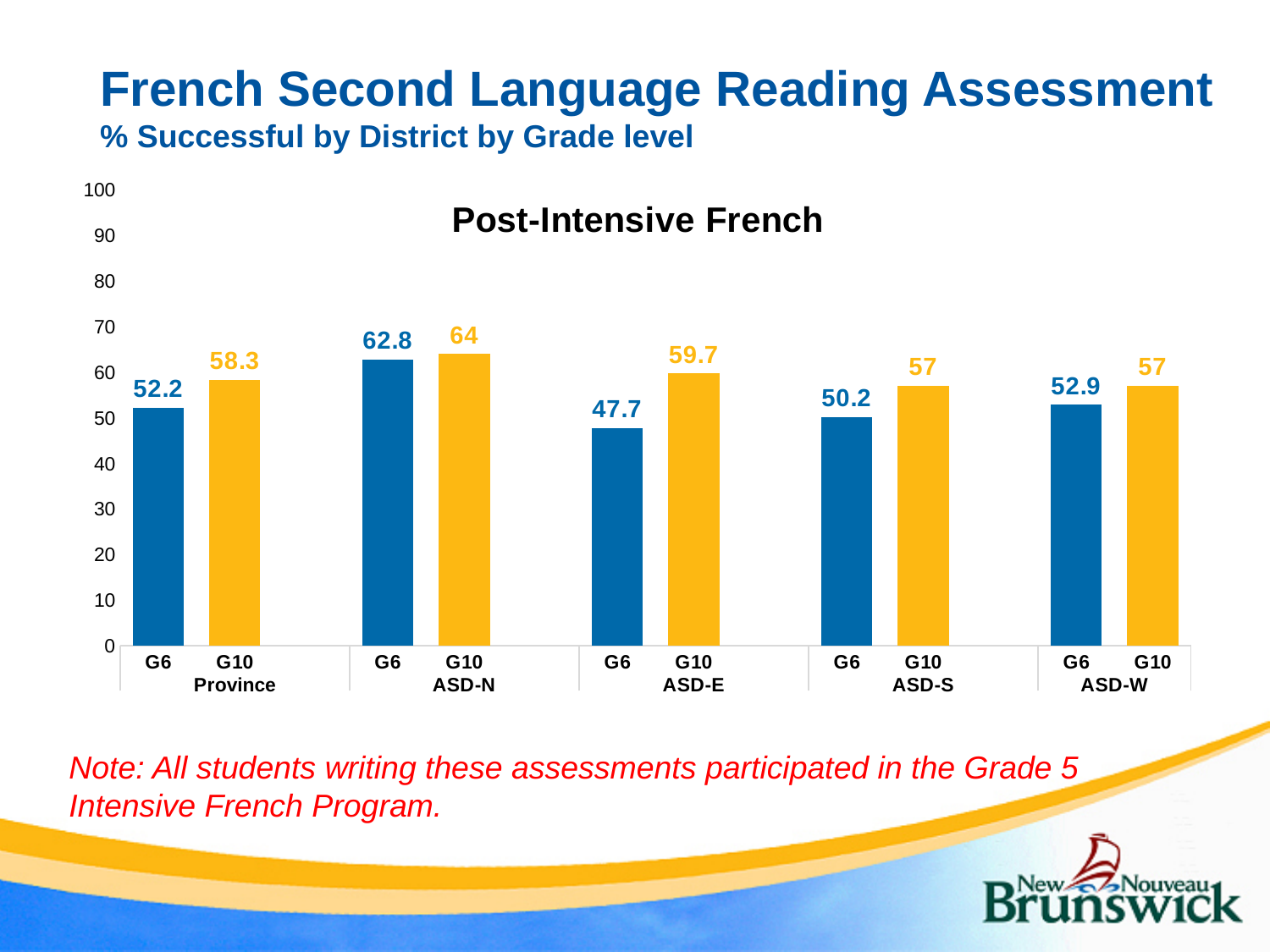
Is the G6 value for ASD-E greater or less than 50? less What is the G6 value for ASD-N? 62.8 What is the G10 value for ASD-E? 59.7 Which is larger, the G6 value for ASD-S or the G6 value for ASD-W? ASD-W G6 Which district and grade has the lowest value on the chart? ASD-E G6 What is the difference between the G10 and G6 values for ASD-E? 12 What is the difference between the G10 and G6 values for the Province? 6.1 Which district and grade has the highest value on the chart? ASD-N G10 What is the title shown inside the chart area? Post-Intensive French What kind of chart is shown on the slide? bar chart How many districts (including the Province) are shown on the chart? 5 What is the G6 value for the Province? 52.2